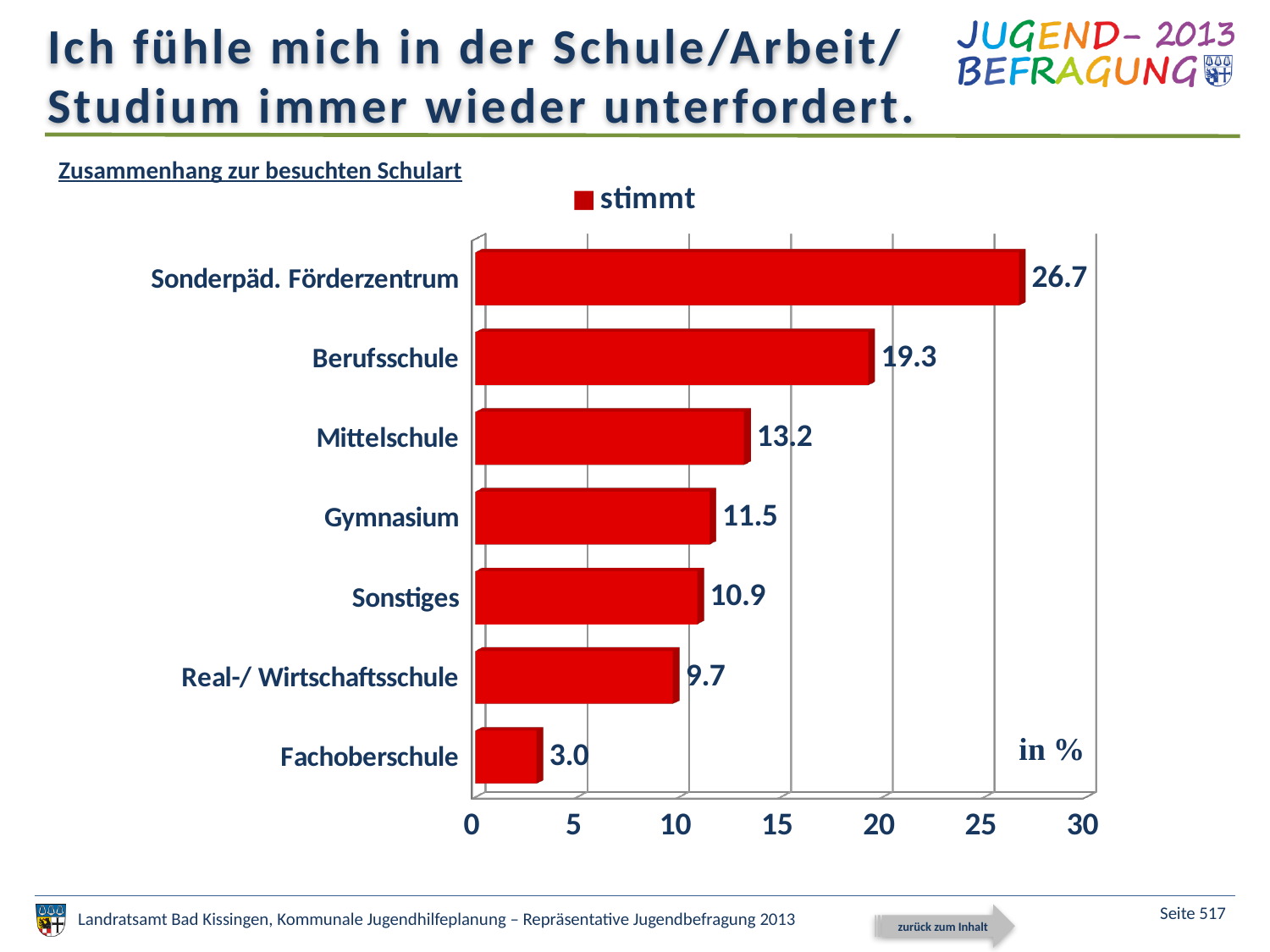
Which category has the lowest value? Fachoberschule Which is larger, the value for Gymnasium or the value for Sonstiges? Gymnasium What is the value for Real-/ Wirtschaftsschule? 9.7 What is the value for Fachoberschule? 3.0 What kind of chart is shown on the slide? bar chart What is the value for Berufsschule? 19.3 What series name does the legend show? stimmt How many categories are shown in the chart? 7 What is the difference between the values for Mittelschule and Gymnasium? 1.7 Which category has the highest value? Sonderpäd. Förderzentrum Is the value for Berufsschule greater or less than 20? less What is the value for Sonderpäd. Förderzentrum? 26.7